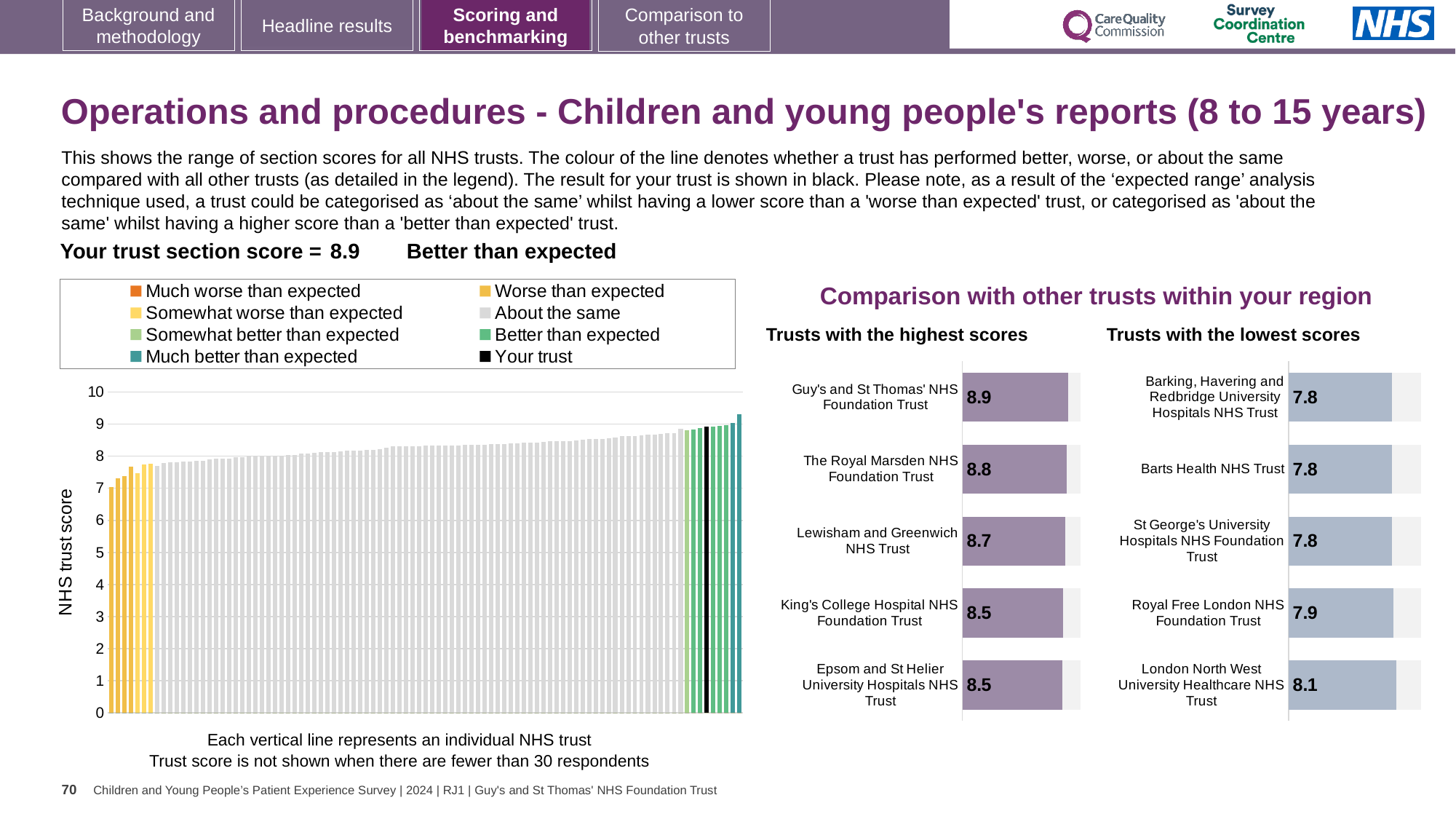
In the 'Trusts with the highest scores' chart, which trust has the highest score? Guy's and St Thomas' NHS Foundation Trust In the 'Trusts with the highest scores' chart, what is the score for The Royal Marsden NHS Foundation Trust? 8.8 In the large chart on the left, is the value for the black 'Your trust' bar greater or less than 8? greater In the 'Trusts with the lowest scores' chart, what is the score for London North West University Healthcare NHS Trust? 8.1 In the 'Trusts with the lowest scores' chart, what is the score for Royal Free London NHS Foundation Trust? 7.9 In the large chart on the left, do the bar values rise or fall from left to right? rise How many entries does the legend of the large chart on the left list? 8 In the 'Trusts with the highest scores' chart, what is the score for Lewisham and Greenwich NHS Trust? 8.7 In the 'Trusts with the lowest scores' chart, which trust has the highest score? London North West University Healthcare NHS Trust In the 'Trusts with the lowest scores' chart, which is larger: the score for London North West University Healthcare NHS Trust or Barts Health NHS Trust? London North West University Healthcare NHS Trust How many trusts are shown in the 'Trusts with the highest scores' chart? 5 In the 'Trusts with the highest scores' chart, what is the difference between the scores of Guy's and St Thomas' NHS Foundation Trust and Lewisham and Greenwich NHS Trust? 0.2